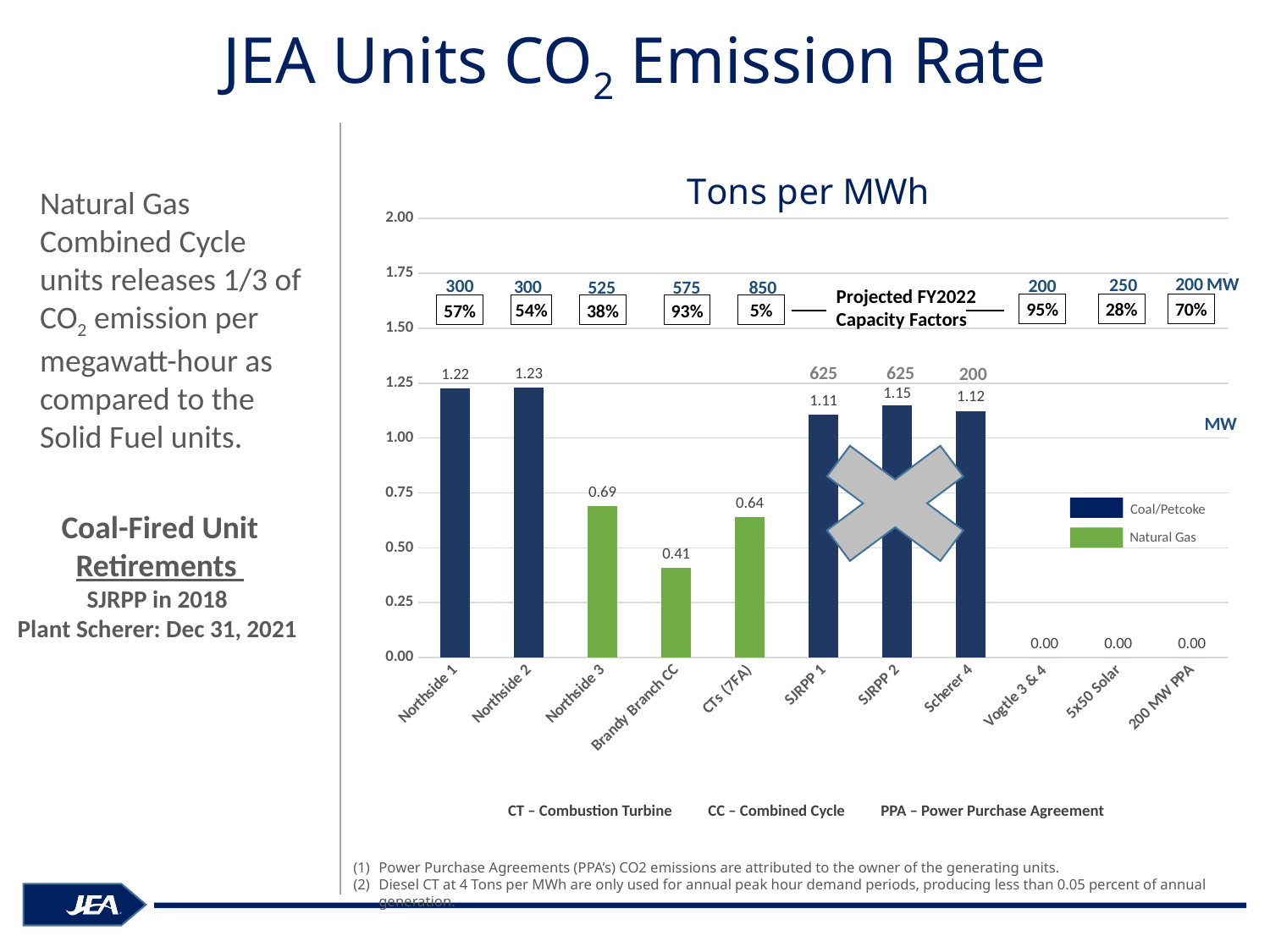
Which has a higher value, Northside 3 or Brandy Branch CC? Northside 3 Is the value for Brandy Branch CC greater or less than 0.50? less How many series does the chart legend list? 2 How many categories are shown on the x axis of the chart? 11 What is the difference between the values for Northside 3 and CTs (7FA)? 0.05 What is the value shown for Brandy Branch CC? 0.41 What is the value shown for Scherer 4? 1.12 What kind of chart is shown on the slide? bar chart What is the difference between the values for Northside 1 and Brandy Branch CC? 0.81 What is the value shown for 5x50 Solar? 0.00 What is the CO2 emission rate in tons per MWh for Northside 1? 1.22 What is the value shown for SJRPP 2? 1.15